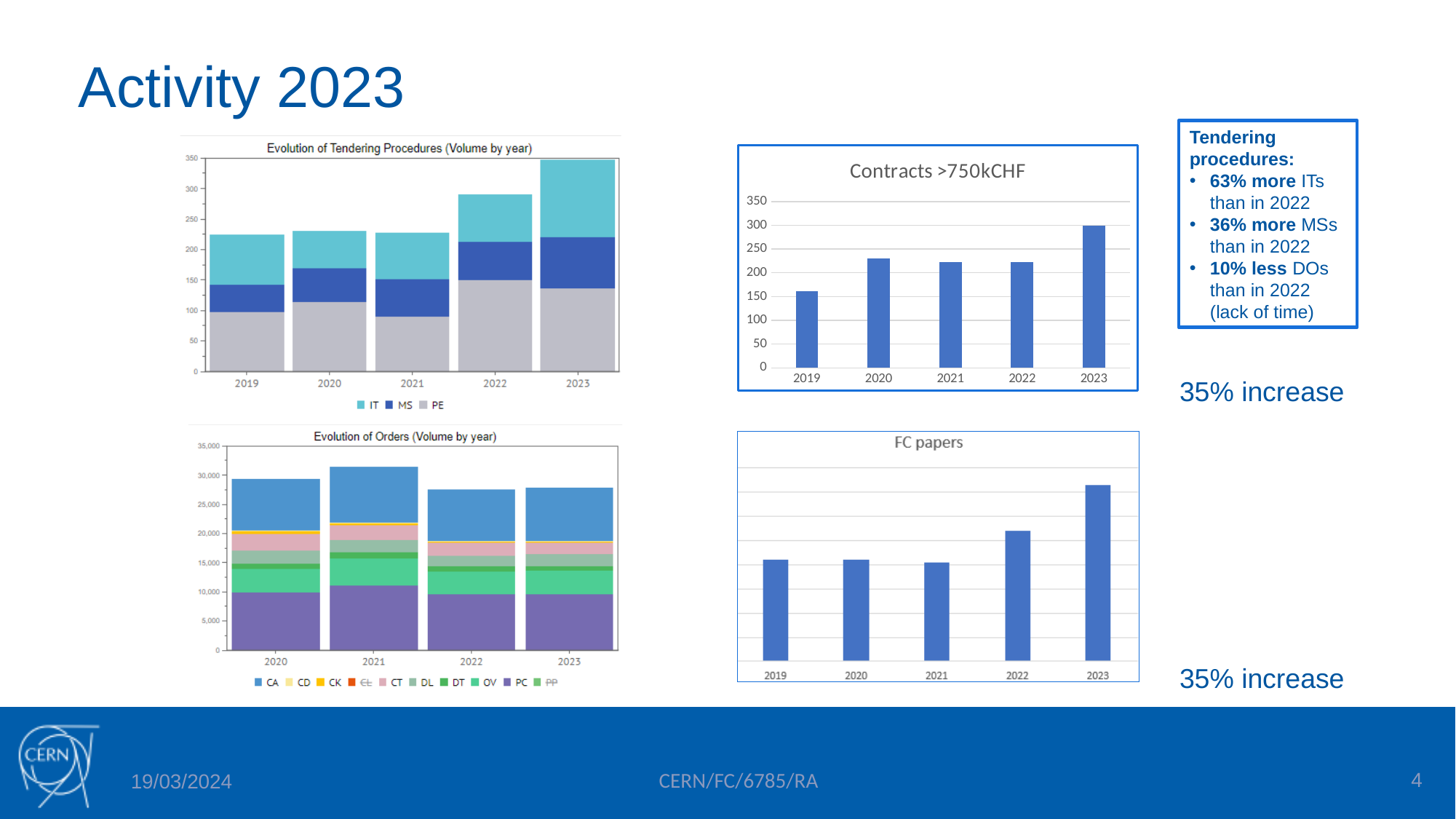
In the 'Contracts >750kCHF' chart, which year has the highest value? 2023 In the 'Contracts >750kCHF' chart, is the value for 2023 greater or less than 250? greater In the 'Evolution of Tendering Procedures (Volume by year)' chart, which year has the tallest stacked bar? 2023 In the 'Contracts >750kCHF' chart, is the value for 2019 greater or less than 200? less What kind of chart is the 'Contracts >750kCHF' chart? bar chart In the 'Contracts >750kCHF' chart, how many years are shown on the x axis? 5 How many series does the legend of the 'Evolution of Tendering Procedures (Volume by year)' chart list? 3 In the 'Evolution of Tendering Procedures (Volume by year)' chart, is the total for 2023 greater or less than 300? greater How many series does the legend of the 'Evolution of Orders (Volume by year)' chart list? 10 In the 'FC papers' chart, which year has the highest bar? 2023 In the 'FC papers' chart, which is larger, the bar for 2022 or the bar for 2023? 2023 In the 'Contracts >750kCHF' chart, which year has the lowest value? 2019